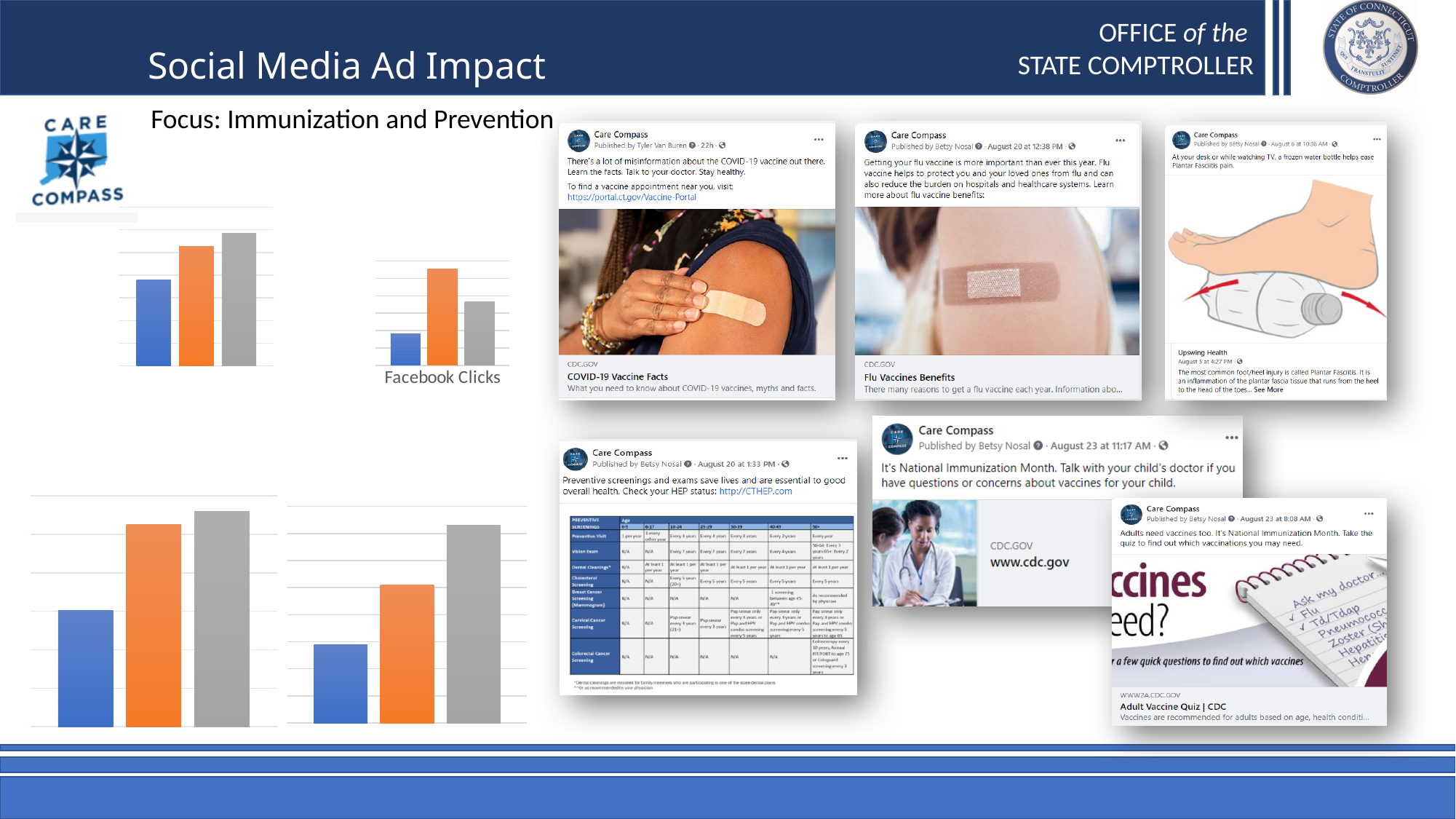
In the bottom-left chart, which bar is the shortest: the blue, orange or gray one? blue What kind of chart is the 'Facebook Clicks' chart? bar chart In the 'Facebook Clicks' chart, which bar is the tallest: the blue, orange or gray one? orange In the 'Facebook Clicks' chart, which bar is the shortest: the blue, orange or gray one? blue In the top-left chart below the Care Compass logo, which bar is the tallest: the blue, orange or gray one? gray How many bars does the bottom-left chart have? 3 In the 'Facebook Clicks' chart, is the gray bar taller or shorter than the orange bar? shorter In the top-left chart below the Care Compass logo, do the bar heights rise or fall from left to right? rise What kind of chart is the top-left chart below the Care Compass logo? bar chart How many bar charts are shown on the slide? 4 In the bottom-middle chart (to the right of the bottom-left chart), which bar is the tallest: the blue, orange or gray one? gray How many bars does the 'Facebook Clicks' chart have? 3